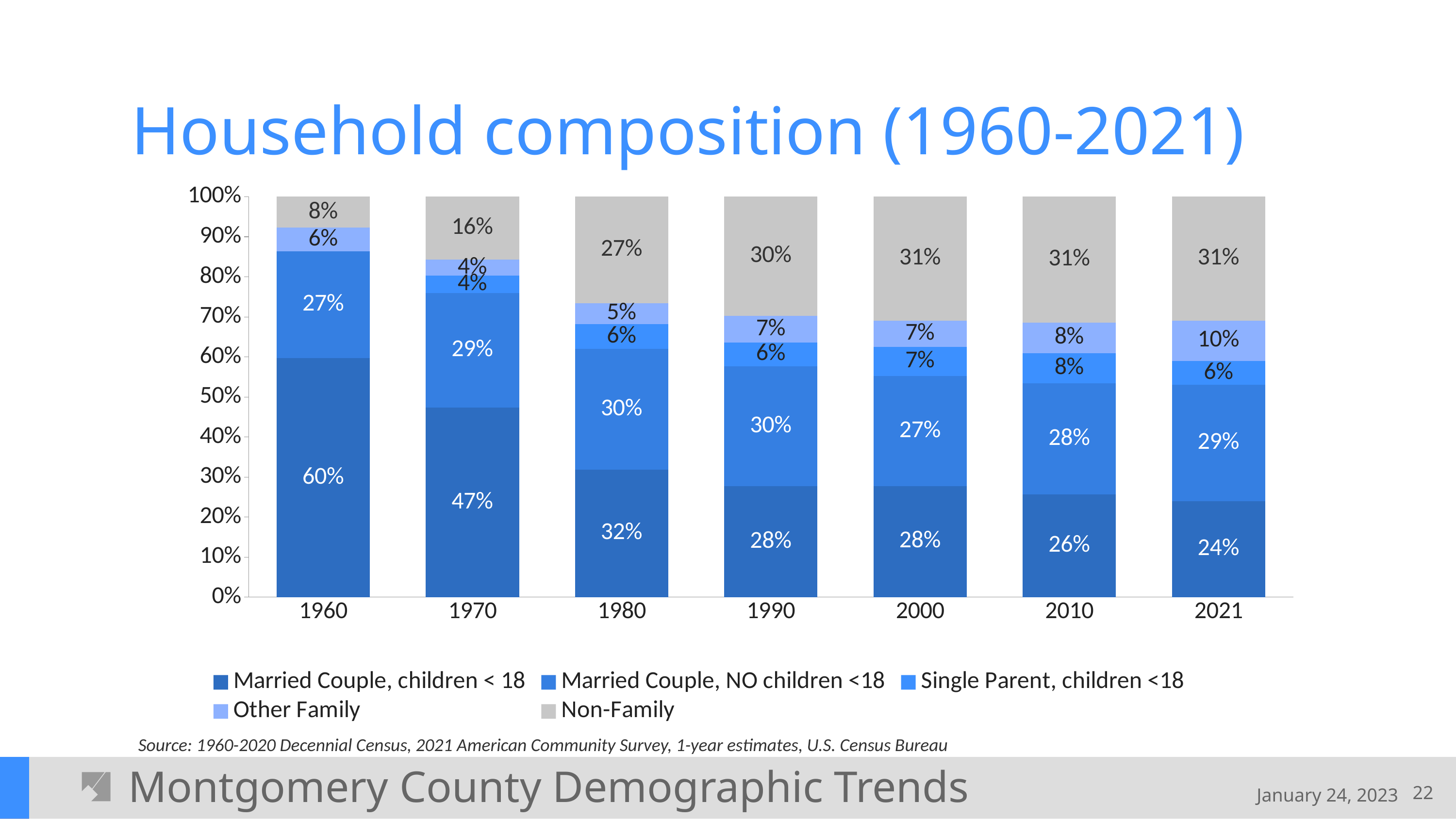
Does the Married Couple, children < 18 share rise or fall from 1960 to 2021? Fall In which year was the Married Couple, children < 18 share the highest? 1960 By how many percentage points did the Married Couple, children < 18 share fall from 1960 to 2021? 36 percentage points In which year was the Non-Family share the lowest? 1960 What percentage of households in 1960 were Married Couple, children < 18? 60% What type of chart is shown on the slide? Stacked bar chart How many household types does the legend list? 5 What is the Other Family share of households in 2021? 10% How many years are shown on the x axis? 7 What is the Non-Family share of households in 2021? 31% What is the Single Parent, children <18 share in 2010? 8% Which is larger in 1990: the Married Couple, NO children <18 share or the Married Couple, children < 18 share? Married Couple, NO children <18